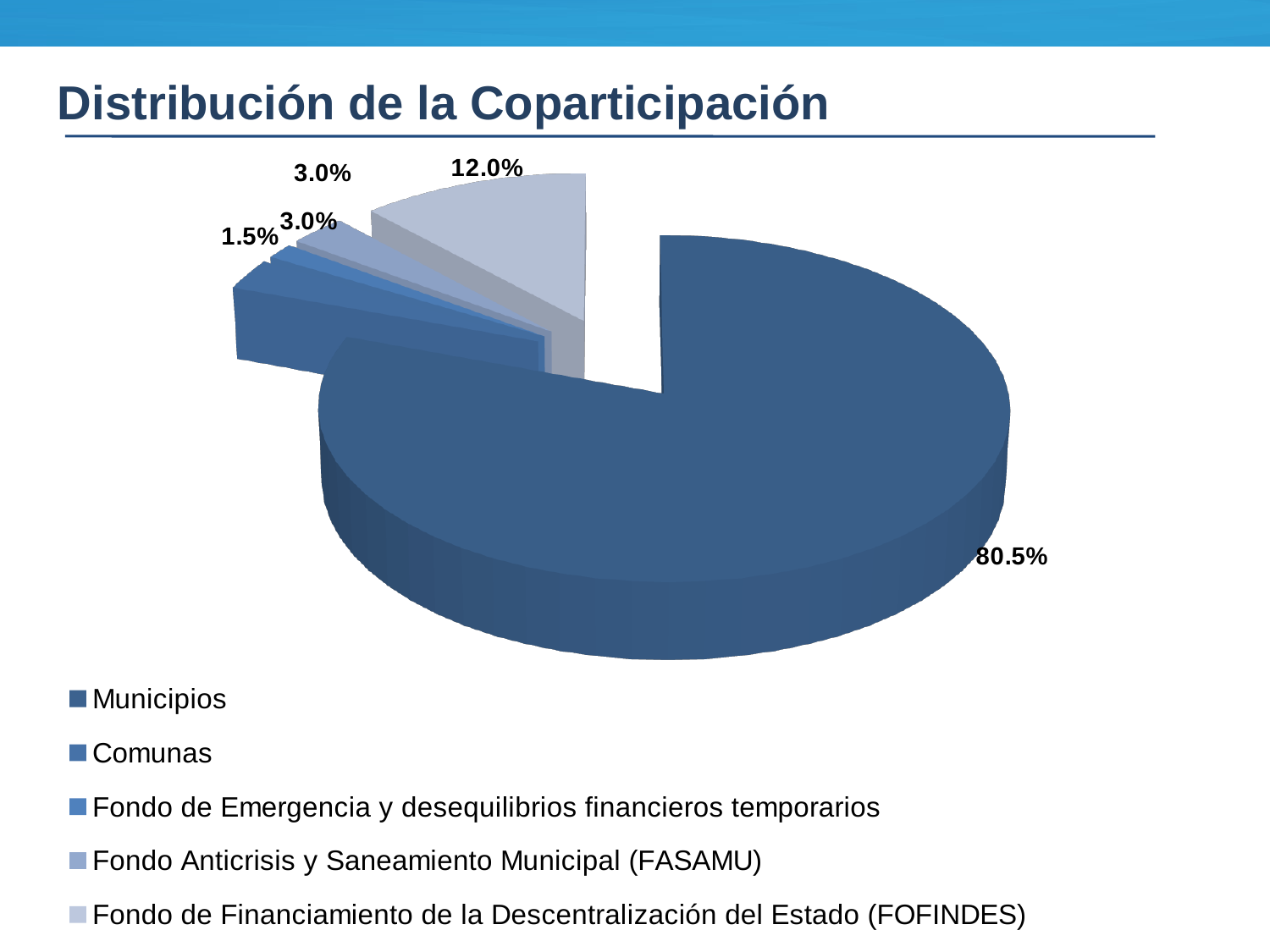
Which category has the largest slice of the pie? Municipios Which category has the smallest slice of the pie? Fondo de Emergencia y desequilibrios financieros temporarios What share of the pie does Fondo de Emergencia y desequilibrios financieros temporarios have? 1.5% Which is larger, the share of FOFINDES or the share of Comunas? FOFINDES What share of the pie does Municipios have? 80.5% What share of the pie does Fondo de Financiamiento de la Descentralización del Estado (FOFINDES) have? 12.0% What share of the pie does Fondo Anticrisis y Saneamiento Municipal (FASAMU) have? 3.0% What is the difference between the shares of Municipios and FOFINDES? 68.5% What kind of chart is shown on the slide? pie chart What share of the pie does Comunas have? 3.0% How many categories does the legend list? 5 What is the title of the chart? Distribución de la Coparticipación